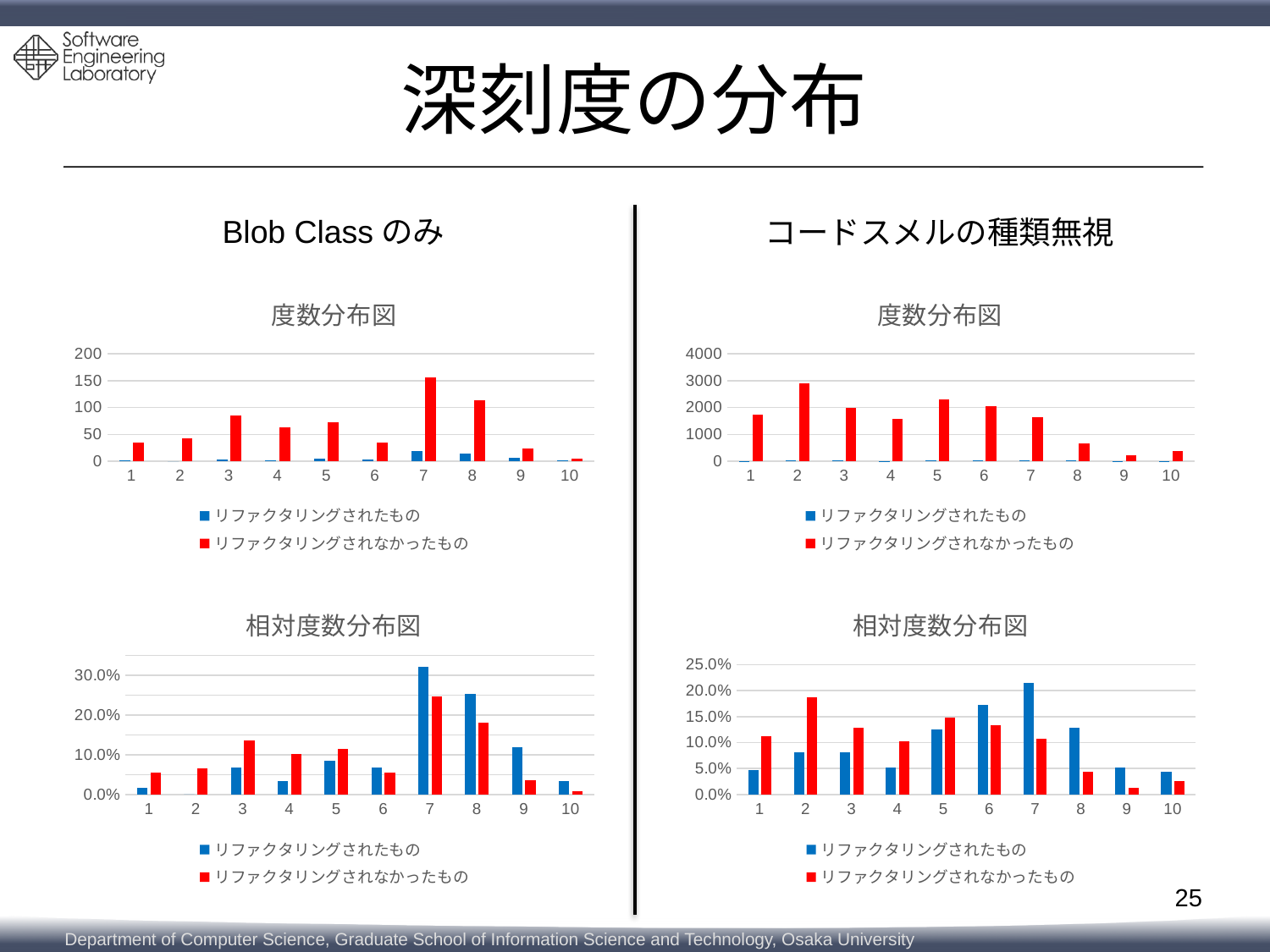
How many series does the legend list for the 相対度数分布図 chart under コードスメルの種類無視 (bottom-right)? 2 In the 相対度数分布図 chart under コードスメルの種類無視 (bottom-right), which series has the larger value at category 2? リファクタリングされなかったもの In the 相対度数分布図 chart under コードスメルの種類無視 (bottom-right), which series has the larger value at category 7? リファクタリングされたもの In the 度数分布図 chart under コードスメルの種類無視 (top-right), which category has the highest value for リファクタリングされなかったもの? 2 In the 相対度数分布図 chart under Blob Class のみ (bottom-left), is the value for リファクタリングされたもの at category 7 greater or less than 20.0%? greater In the 度数分布図 chart under コードスメルの種類無視 (top-right), is the value for リファクタリングされなかったもの at category 2 greater or less than 2000? greater In the 相対度数分布図 chart under Blob Class のみ (bottom-left), which category has the highest value for リファクタリングされたもの? 7 In the 度数分布図 chart under コードスメルの種類無視 (top-right), which category has the lowest value for リファクタリングされなかったもの? 9 How many categories are shown on the x axis of the 度数分布図 chart under コードスメルの種類無視 (top-right)? 10 In the 度数分布図 chart under Blob Class のみ (top-left), is the value for リファクタリングされなかったもの at category 7 greater or less than 100? greater What kind of chart is the 度数分布図 chart under Blob Class のみ (top-left)? bar chart In the 度数分布図 chart under Blob Class のみ (top-left), which category has the highest value for リファクタリングされなかったもの? 7